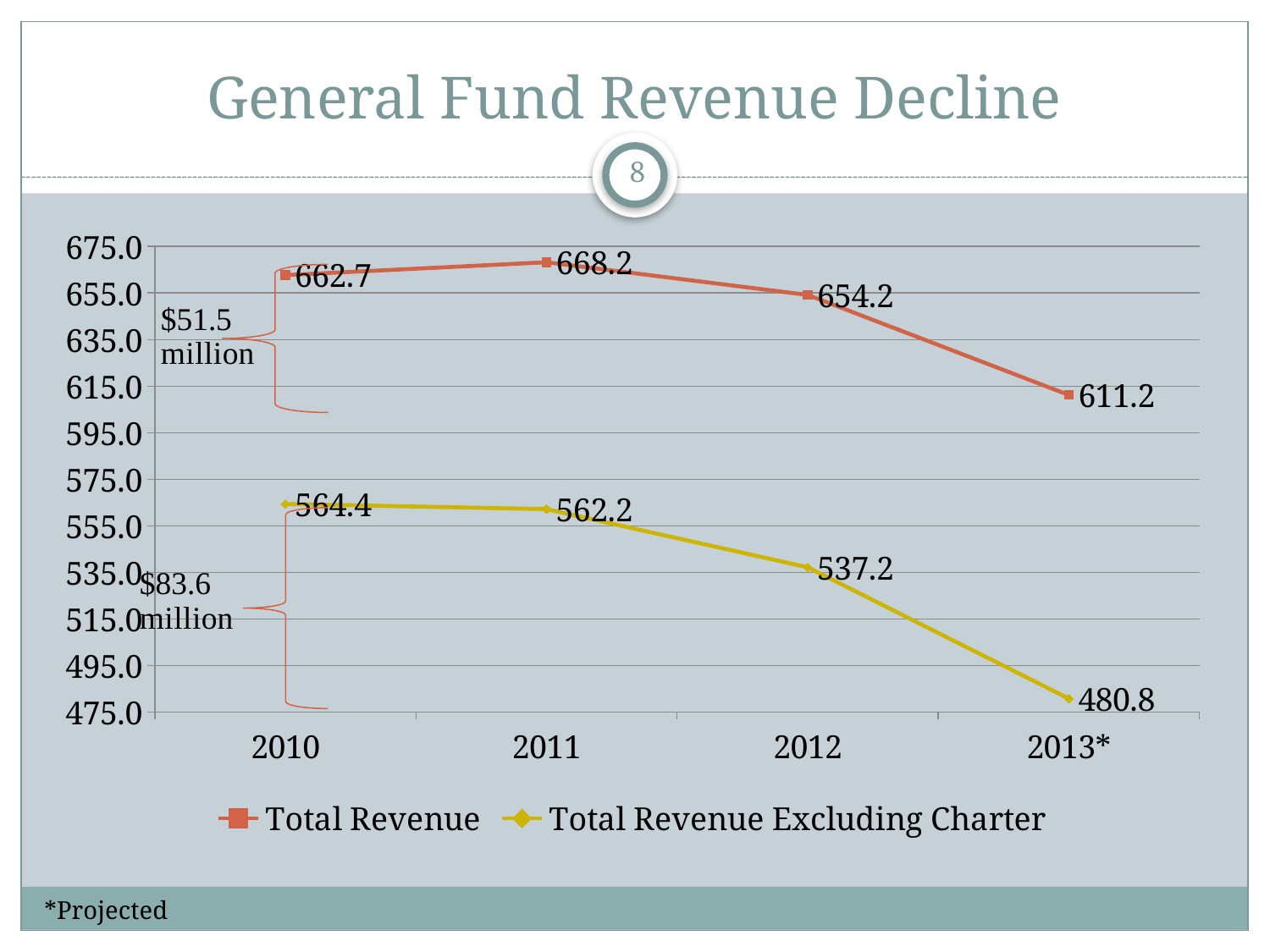
What is the Total Revenue Excluding Charter value for 2013*? 480.8 Does Total Revenue Excluding Charter rise or fall from 2010 to 2013*? fall What kind of chart is shown on the slide? line chart How many years are shown on the x axis? 4 What is the Total Revenue value for 2012? 654.2 In which year is Total Revenue Excluding Charter lowest? 2013* Which is larger: Total Revenue Excluding Charter in 2010 or in 2012? 2010 What is the Total Revenue value for 2011? 668.2 In which year is Total Revenue highest? 2011 What is the difference between Total Revenue and Total Revenue Excluding Charter in 2010? 98.3 What is the difference between Total Revenue in 2011 and Total Revenue in 2013*? 57.0 How many series does the legend list? 2